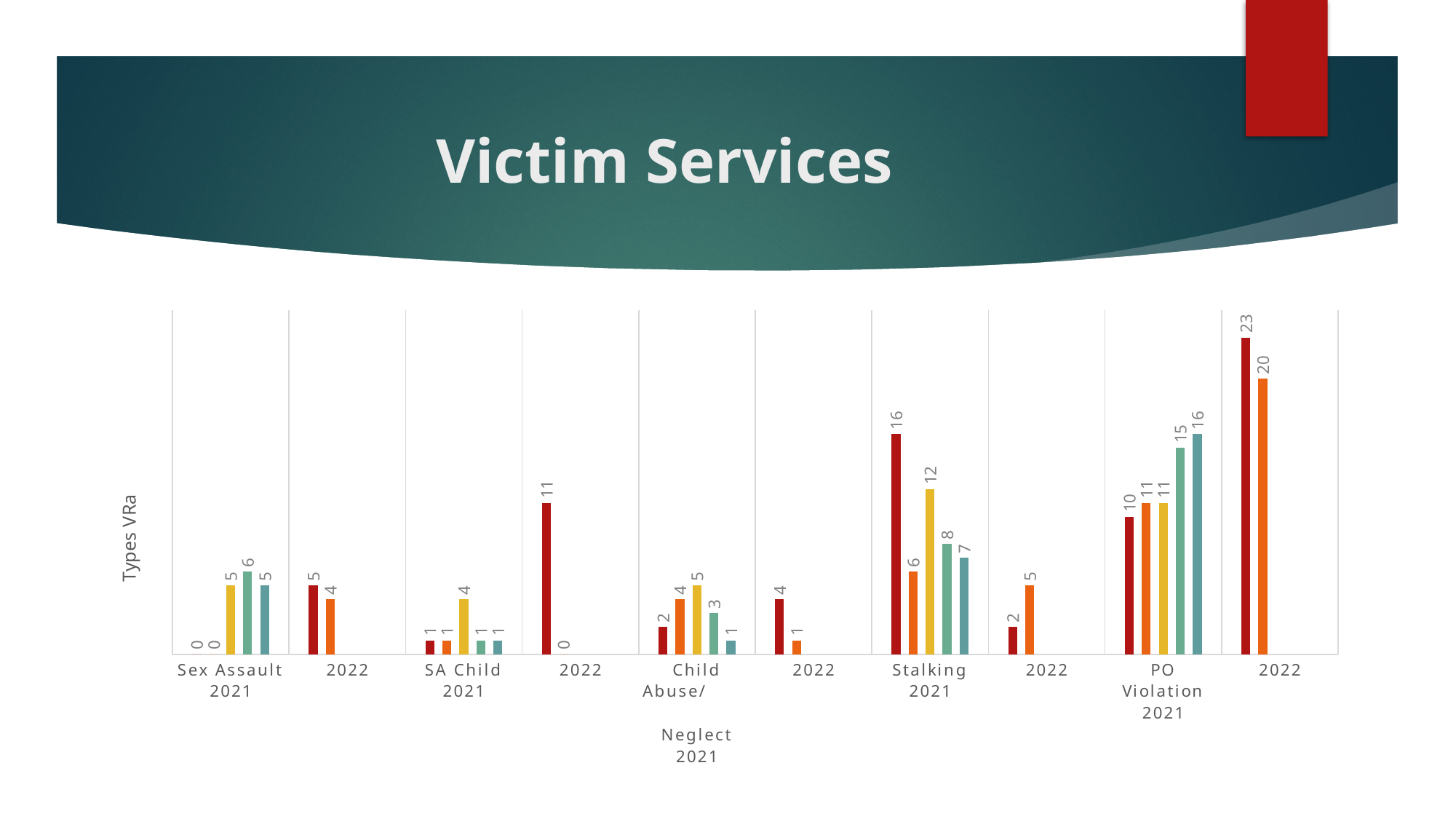
What is the value of the yellow (third) bar for Stalking 2021? 12 Which is larger: the dark red bar for Stalking 2021 or the dark red bar for PO Violation 2021? Stalking 2021 How many categories are shown along the x axis of the chart? 10 What is the value of the orange (second) bar for the 2022 category following PO Violation 2021? 20 Which category contains the highest labelled bar in the chart? 2022 (following PO Violation 2021) What is the value of the dark red (first) bar for the 2022 category following SA Child 2021? 11 What is the difference between the dark red bar (23) and the orange bar (20) in the 2022 category following PO Violation 2021? 3 What is the difference between the dark red bar (16) and the orange bar (6) for Stalking 2021? 10 What is the label on the vertical axis of the chart? Types VRa What kind of chart is shown on the slide? bar chart How many differently coloured bars are shown for the Sex Assault 2021 category? 5 What is the value of the dark red (first) bar for Stalking 2021? 16